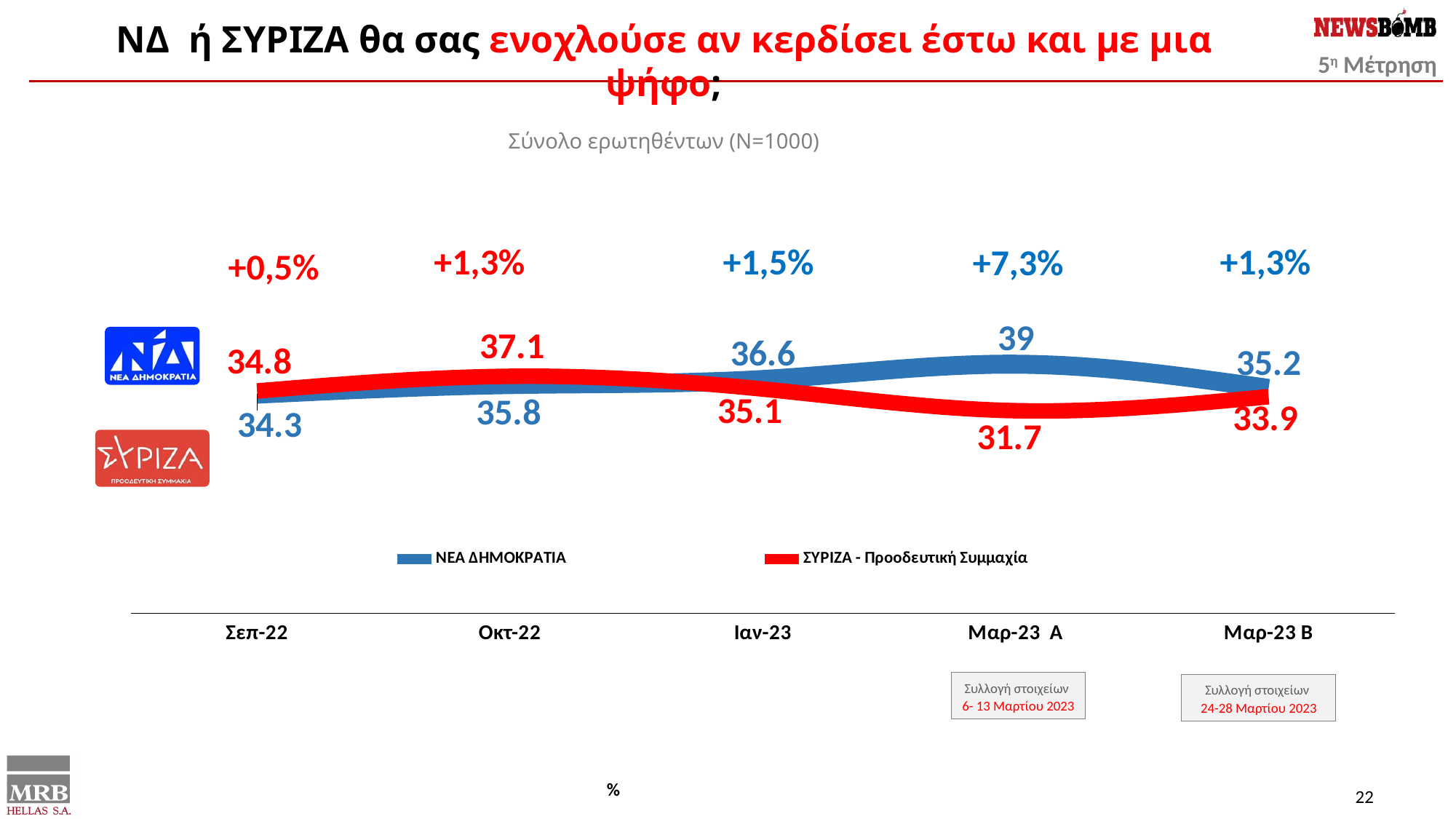
What is the value for ΣΥΡΙΖΑ - Προοδευτική Συμμαχία at Μαρ-23 Β? 33.9 What is the value for ΣΥΡΙΖΑ - Προοδευτική Συμμαχία at Οκτ-22? 37.1 What kind of chart is shown on the slide? line chart Does the ΣΥΡΙΖΑ - Προοδευτική Συμμαχία line rise or fall from Οκτ-22 to Μαρ-23 Α? fall How many series does the legend list? 2 Which series has the larger value at Σεπ-22, ΝΕΑ ΔΗΜΟΚΡΑΤΙΑ or ΣΥΡΙΖΑ - Προοδευτική Συμμαχία? ΣΥΡΙΖΑ - Προοδευτική Συμμαχία What is the value for ΝΕΑ ΔΗΜΟΚΡΑΤΙΑ at Μαρ-23 Α? 39 What is the difference between ΝΕΑ ΔΗΜΟΚΡΑΤΙΑ and ΣΥΡΙΖΑ - Προοδευτική Συμμαχία at Μαρ-23 Α? 7.3 Which colour represents ΝΕΑ ΔΗΜΟΚΡΑΤΙΑ in the chart? blue How many time points are plotted along the x axis? 5 At which time point does ΣΥΡΙΖΑ - Προοδευτική Συμμαχία have its lowest value? Μαρ-23 Α At which time point does ΝΕΑ ΔΗΜΟΚΡΑΤΙΑ reach its highest value? Μαρ-23 Α